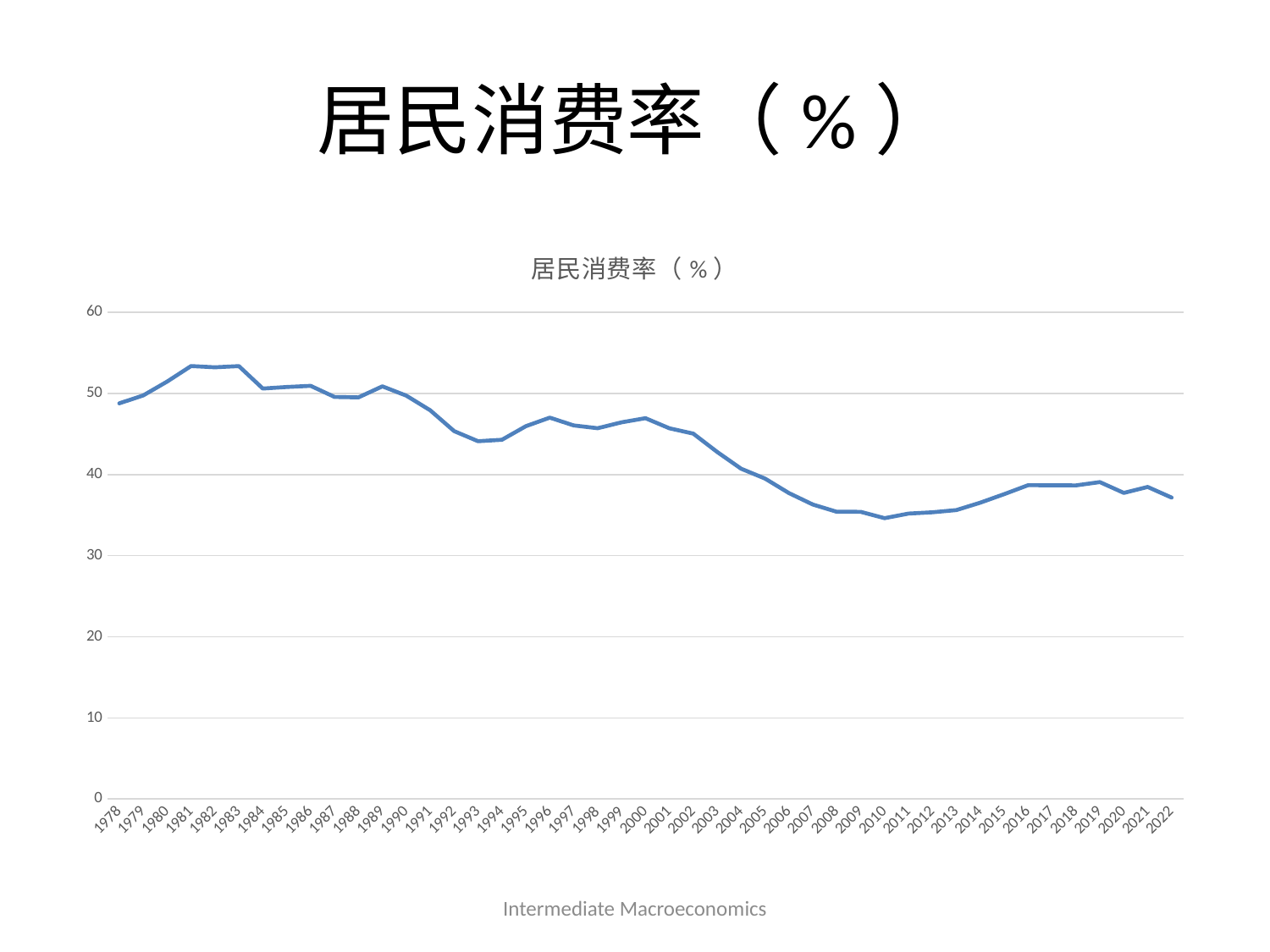
Overall, does the value rise or fall from 1978 to 2022? fall Is the value for 2022 greater or less than 40? less Is the value for 1978 greater or less than 40? greater What is the title of the chart? 居民消费率（%） What kind of chart is shown on the slide? line chart Is the value for 2010 greater or less than 40? less How many years are plotted along the x axis of the chart? 45 Which is larger, the value for 1981 or the value for 2010? 1981 Which year has the lowest value on the chart? 2010 Which is larger, the value for 1996 or the value for 2005? 1996